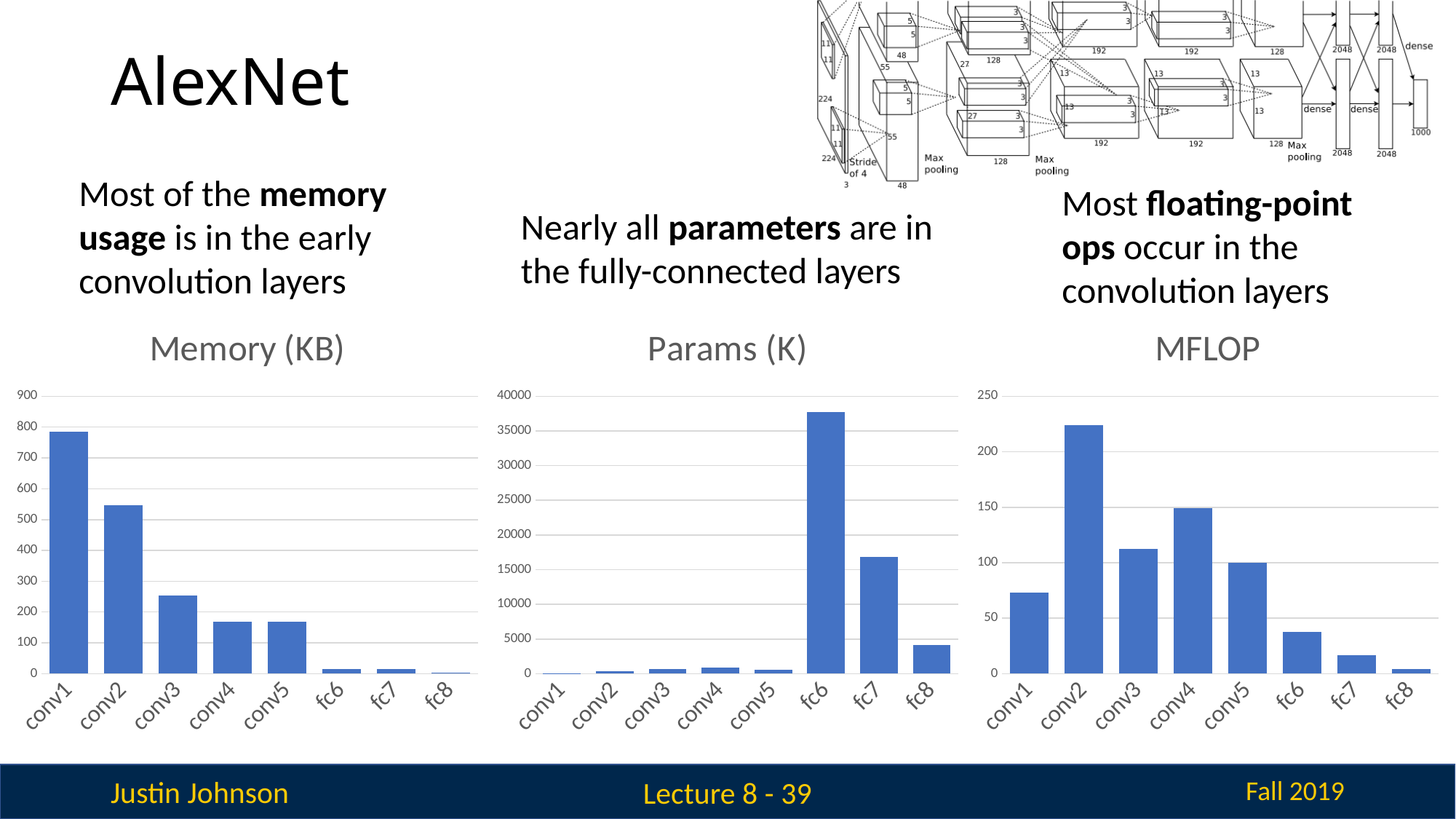
In the MFLOP chart, which layer has the highest value? conv2 In the Memory (KB) chart, which layer has the highest value? conv1 In the Params (K) chart, which is larger, the value for fc7 or the value for conv4? fc7 In the MFLOP chart, is the value for conv2 greater or less than 200? greater In the Memory (KB) chart, which layer has the lowest value? fc8 How many layers are shown on the x axis of the MFLOP chart? 8 In the Memory (KB) chart, is the value for conv3 greater or less than 300? less In the Params (K) chart, is the value for fc8 greater or less than 5000? less In the Params (K) chart, which layer has the highest value? fc6